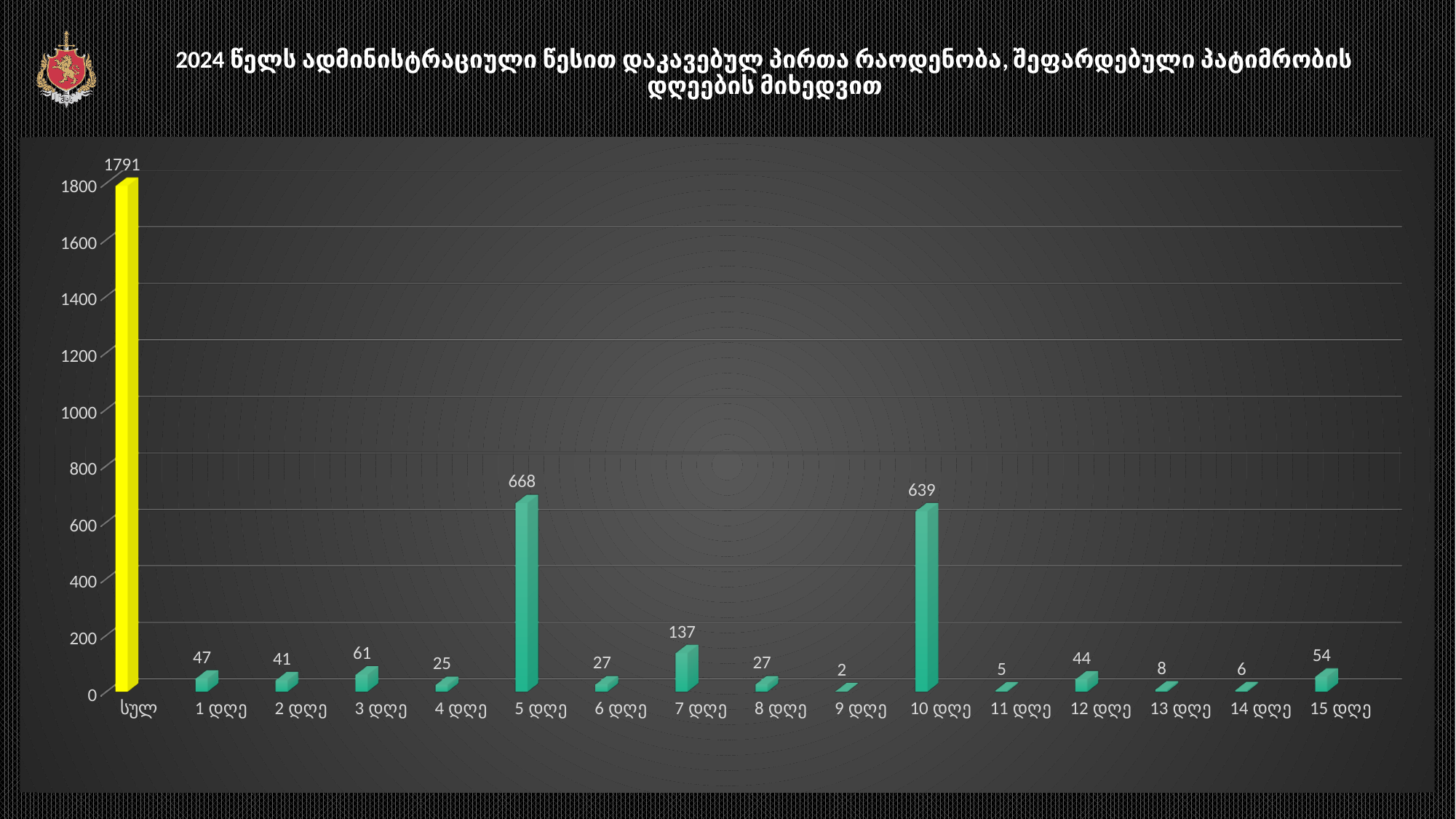
Which is larger, the value for "3 დღე" or the value for "15 დღე"? 15 დღე How many categories are shown on the x axis? 16 What is the value for "10 დღე"? 639 What colour is the "სულ" bar? yellow Excluding the "სულ" total bar, which day category has the highest value? 5 დღე What kind of chart is shown on the slide? bar chart What is the value for the "სულ" bar? 1791 Is the value for "7 დღე" greater or less than 200? less What is the value for "5 დღე"? 668 What is the value for "7 დღე"? 137 Which category has the lowest value? 9 დღე What is the difference between the values for "5 დღე" and "10 დღე"? 29